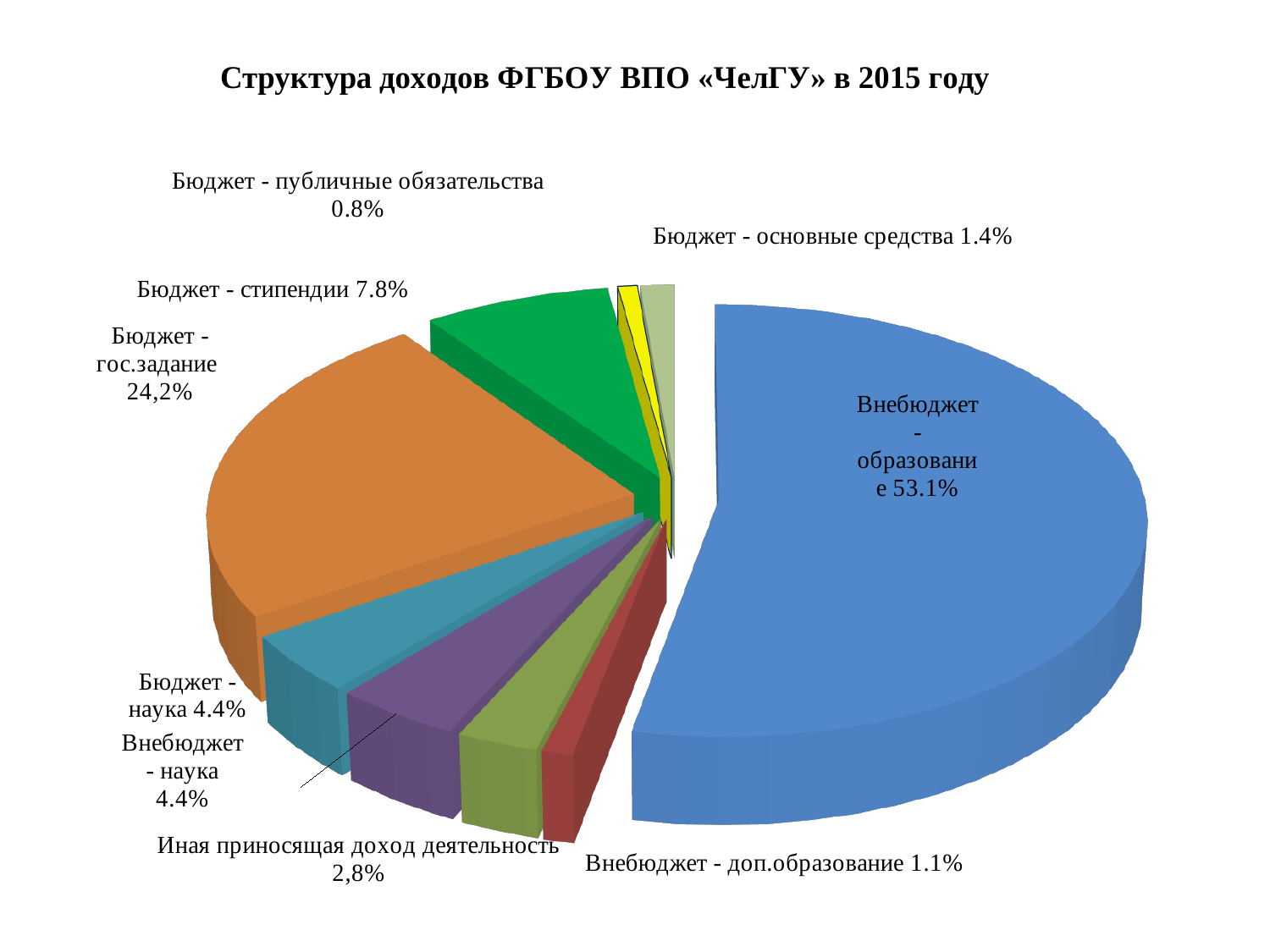
What type of chart is shown on the slide? Pie chart What percentage is shown for "Бюджет - стипендии"? 7.8% What percentage does the slice "Внебюджет - образование" represent? 53.1% How many slices does the pie chart have? 9 Which category has the largest share of the pie? Внебюджет - образование Which category has the smallest share of the pie? Бюджет - публичные обязательства What is the value shown for "Бюджет - гос.задание"? 24,2% What is the title of the chart? Структура доходов ФГБОУ ВПО «ЧелГУ» в 2015 году Which is larger: the share of "Бюджет - основные средства" or "Бюджет - публичные обязательства"? Бюджет - основные средства What value is labelled for "Иная приносящая доход деятельность"? 2,8% What is the difference between the shares of "Бюджет - стипендии" and "Бюджет - наука"? 3.4% What percentage is shown for "Внебюджет - доп.образование"? 1.1%